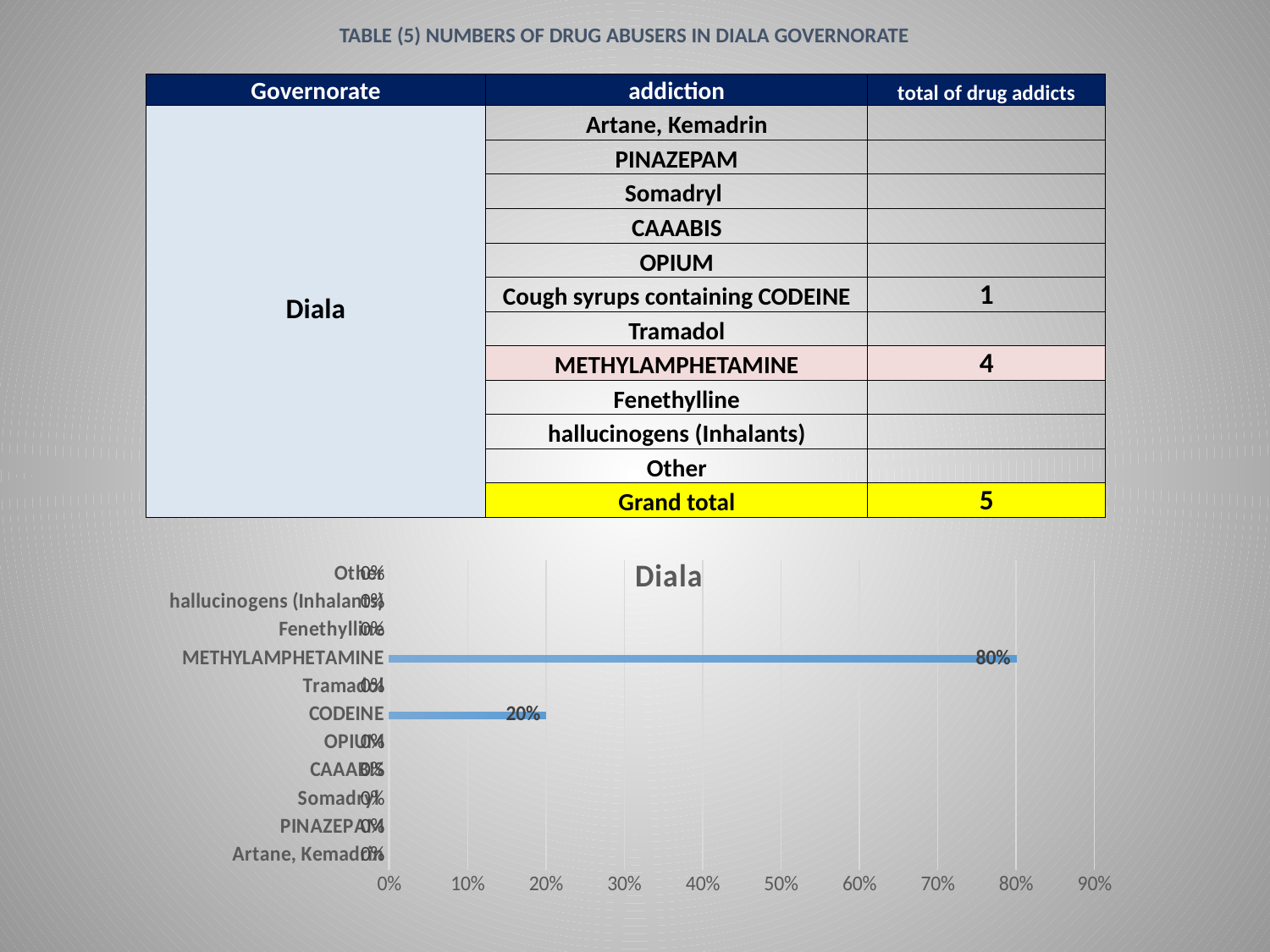
Is the value for METHYLAMPHETAMINE in the chart greater or less than 50%? greater What is the value for CODEINE in the chart? 20% How many categories are shown on the chart's vertical axis? 11 What is the highest value shown on the chart's horizontal axis? 90% Which category has the highest value in the chart? METHYLAMPHETAMINE Which is larger in the chart, the value for CODEINE or the value for METHYLAMPHETAMINE? METHYLAMPHETAMINE What is the title of the chart? Diala What type of chart is shown on the slide? bar chart What is the value for METHYLAMPHETAMINE in the chart? 80% Is the value for CODEINE in the chart greater or less than 30%? less What is the difference between the values for METHYLAMPHETAMINE and CODEINE in the chart? 60% What is the value for Tramadol in the chart? 0%